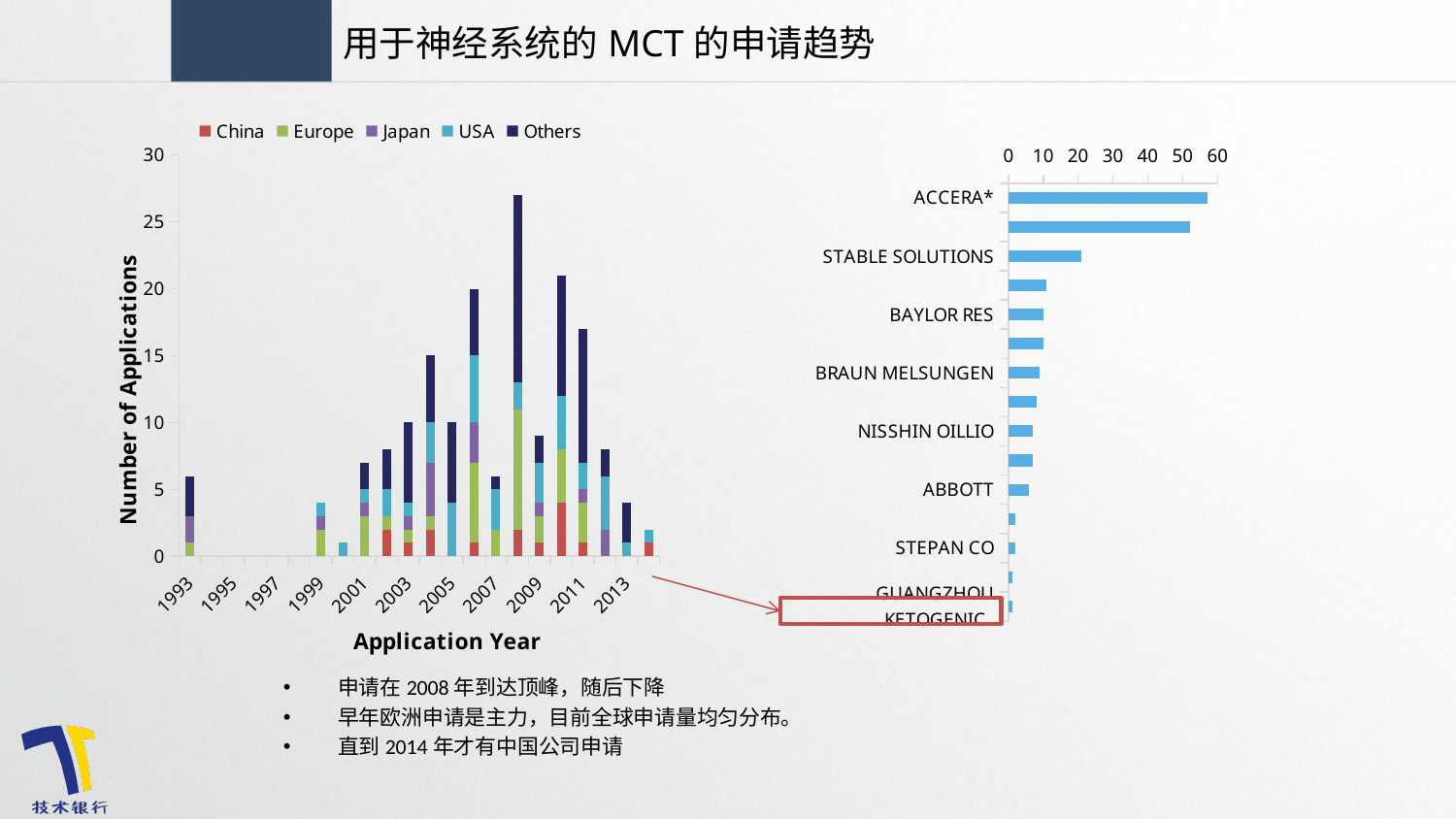
In the right chart, which applicant has the highest value? ACCERA* What kind of chart is the left chart? stacked bar chart In the left chart, is the total for 2011 greater or less than 15? greater In the left chart, do the totals rise or fall from 2008 to 2014? fall In the right chart, which is larger, ACCERA* or STABLE SOLUTIONS? ACCERA* In the left chart, is the total for 2008 greater or less than 25? greater In the left chart, how many series does the legend list? 5 In the left chart, is the total for 2013 greater or less than 5? less In the left chart, which year has the highest total number of applications? 2008 What is the y-axis title of the left chart? Number of Applications